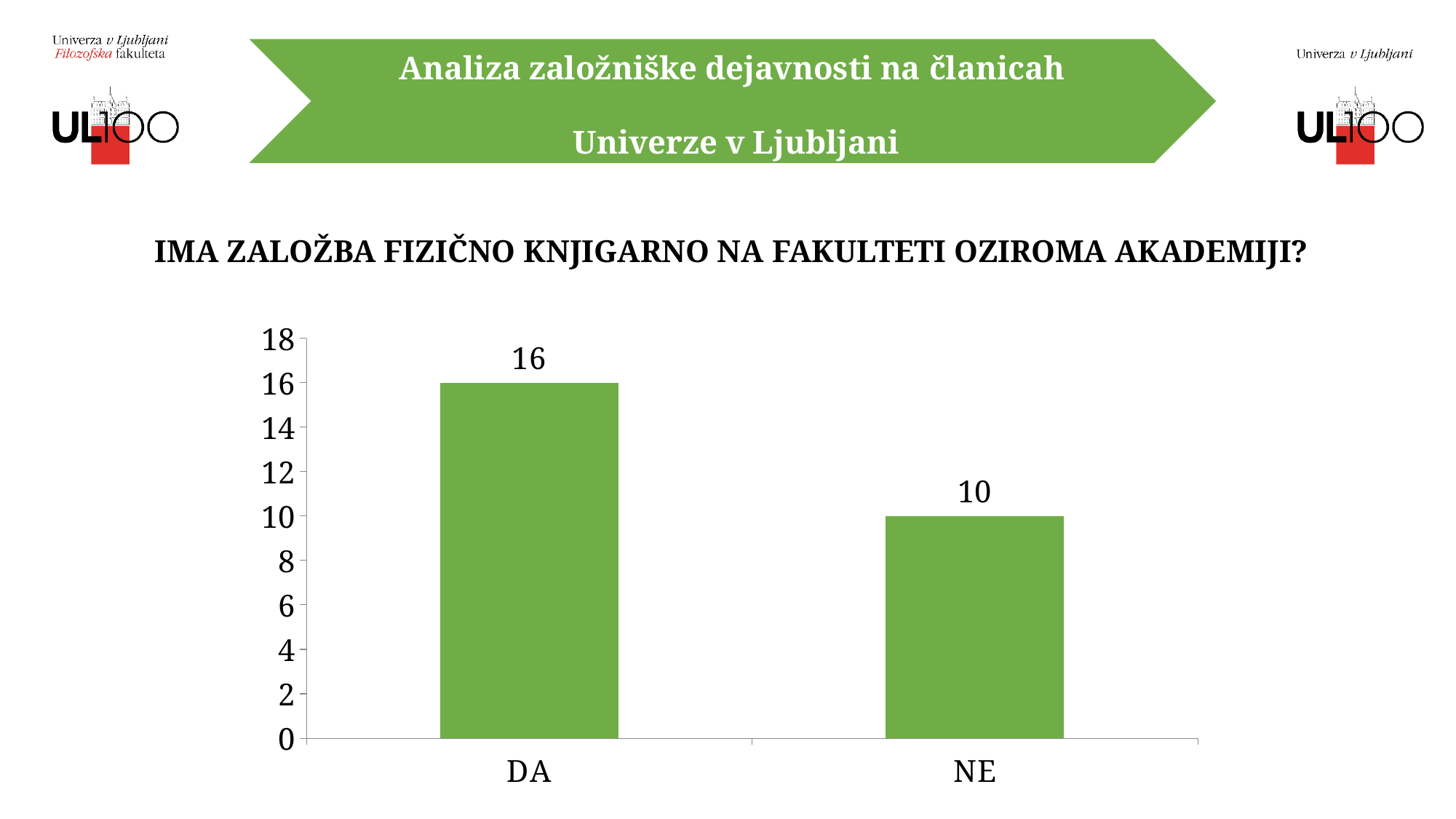
How many categories are shown on the x axis? 2 What question is the chart answering, as written above it? IMA ZALOŽBA FIZIČNO KNJIGARNO NA FAKULTETI OZIROMA AKADEMIJI? Which is larger, the value for DA or the value for NE? DA Which category has the highest value? DA What is the difference between the values for DA and NE? 6 What is the value for NE? 10 Is the value for DA greater or less than 14? greater What kind of chart is shown on the slide? bar chart Which category has the lowest value? NE What is the value for DA? 16 Is the value for NE greater or less than 12? less What is the total of the values for DA and NE? 26